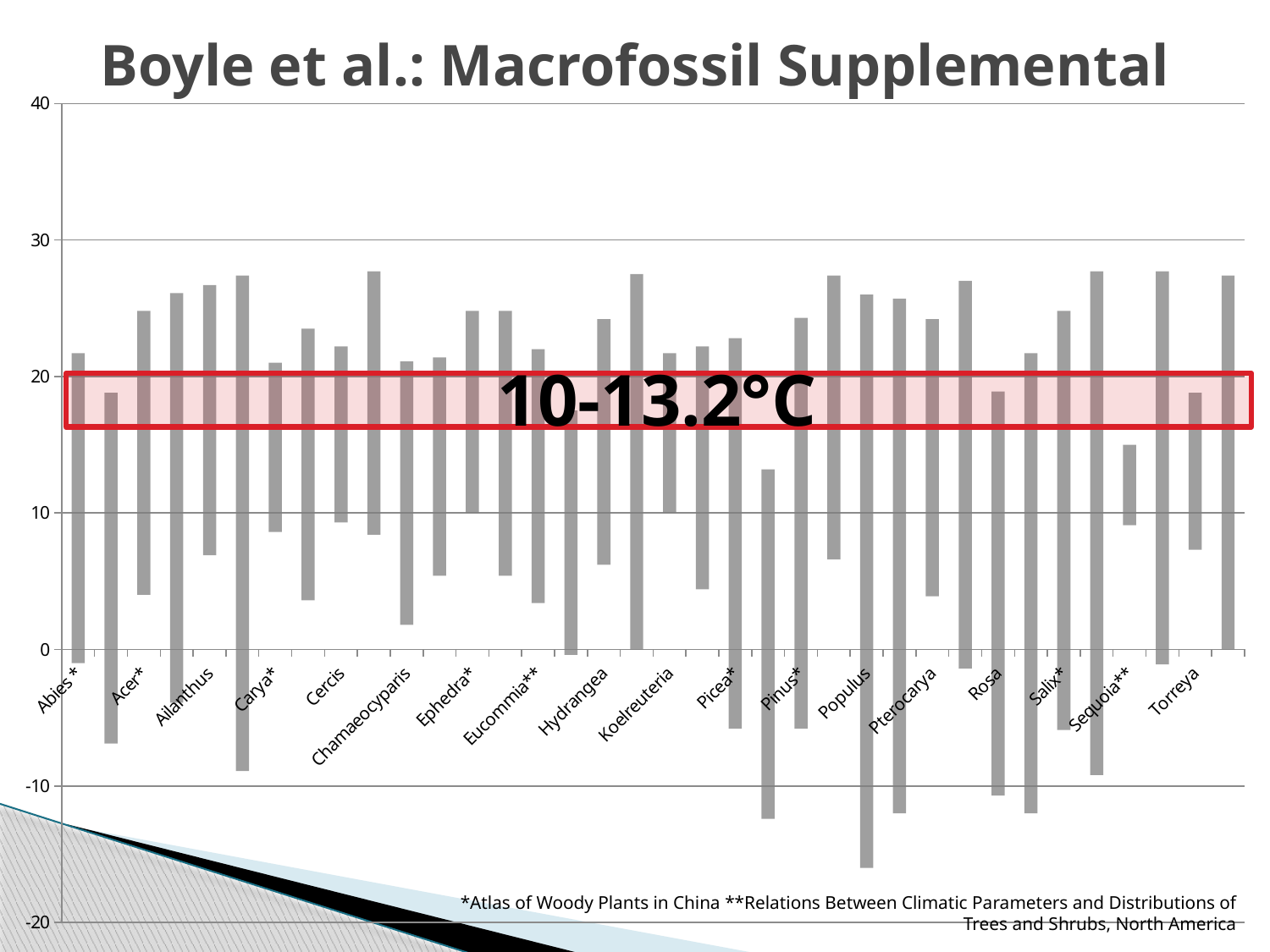
Is the bottom of the bar for Abies* greater or less than 10? less How many category labels are printed along the x axis? 18 What is the lowest value shown on the vertical axis? -20 What kind of chart is shown on the slide? bar chart Is the top of the bar for Ailanthus greater or less than 20? greater What is the highest value shown on the vertical axis? 40 Is the bottom of the bar for Populus greater or less than -10? less What temperature range is printed inside the red highlighted band on the chart? 10-13.2°C What is the title of the chart? Boyle et al.: Macrofossil Supplemental